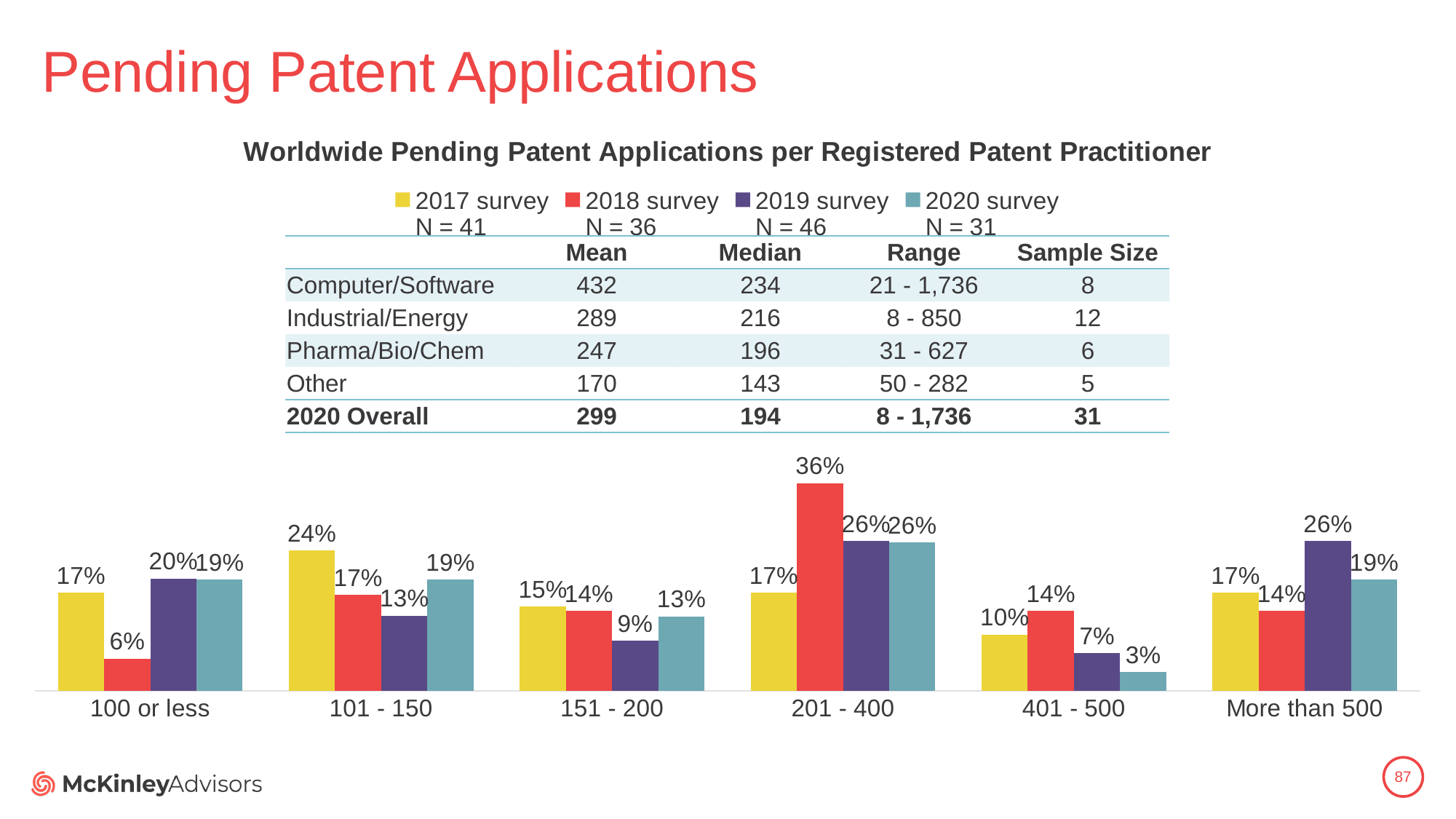
What is the value for the 2020 survey in the 401 - 500 category? 3% Which category has the lowest value for the 2018 survey? 100 or less What is the title of the chart? Worldwide Pending Patent Applications per Registered Patent Practitioner What is the value for the 2018 survey in the 201 - 400 category? 36% What is the value for the 2019 survey in the More than 500 category? 26% What is the difference between the 2018 survey and 2017 survey values in the 201 - 400 category? 19% Which category has the highest value for the 2017 survey? 101 - 150 How many categories are shown along the x axis of the chart? 6 What is the sample size (N) for the 2020 survey shown in the legend? N = 31 How many series does the chart legend list? 4 In the 100 or less category, which is larger: the 2019 survey value or the 2020 survey value? 2019 survey What type of chart is shown on the slide? bar chart